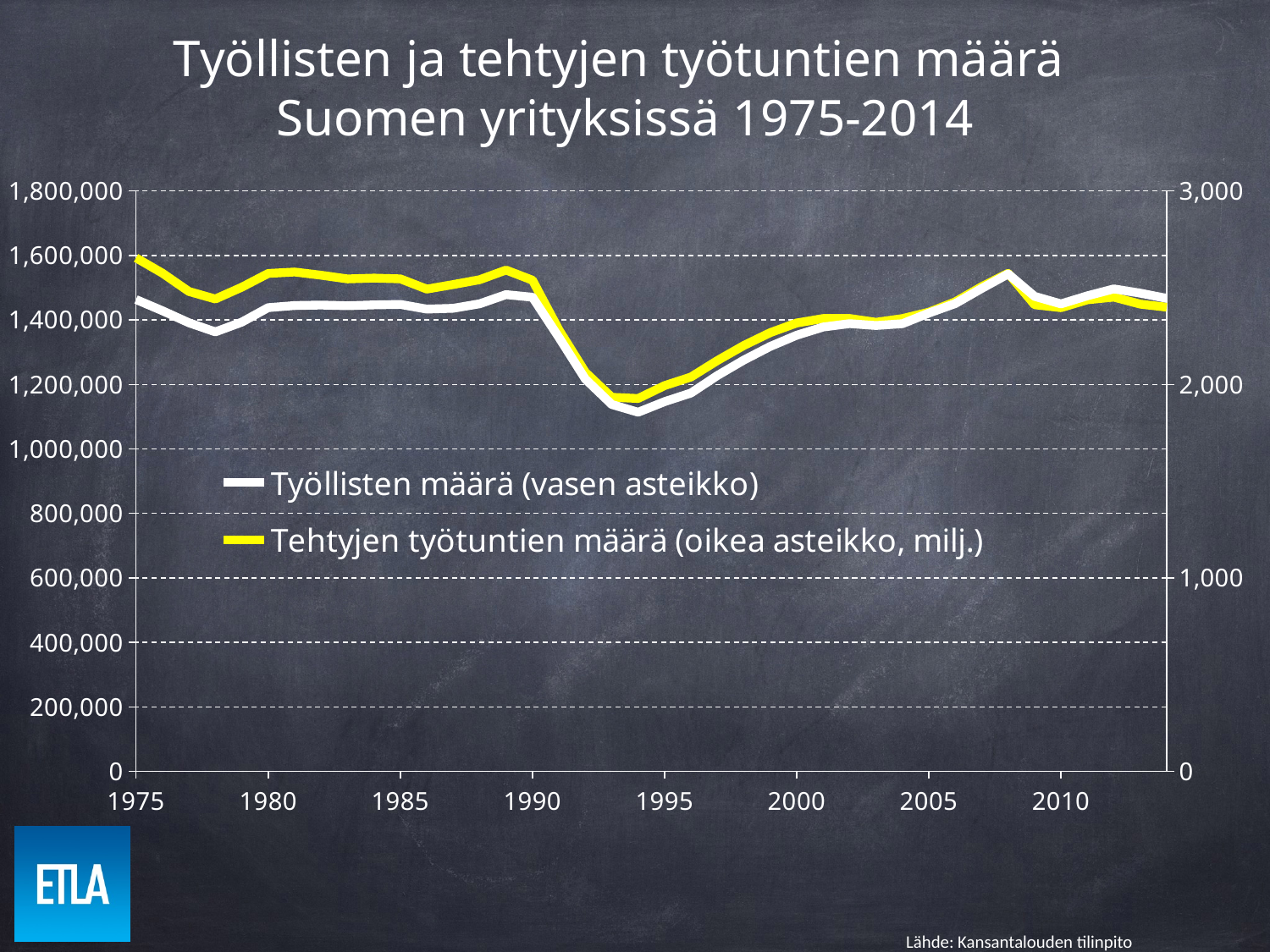
Is the value of Työllisten määrä in 1975 greater or less than 1,400,000? greater What kind of chart is shown on the slide? line chart Is the value of Työllisten määrä in 2008 greater or less than 1,400,000? greater Does the Työllisten määrä line rise or fall between 1994 and 2000? rise Is the value of Työllisten määrä in 1994 greater or less than 1,200,000? less What is the title of the chart? Työllisten ja tehtyjen työtuntien määrä Suomen yrityksissä 1975-2014 How many series does the legend list? 2 What is the highest value shown on the left axis? 1,800,000 Around which year does the Työllisten määrä line reach its lowest point? 1994 Which series is drawn in yellow? Tehtyjen työtuntien määrä (oikea asteikko, milj.) Does the Työllisten määrä line rise or fall between 1990 and 1994? fall